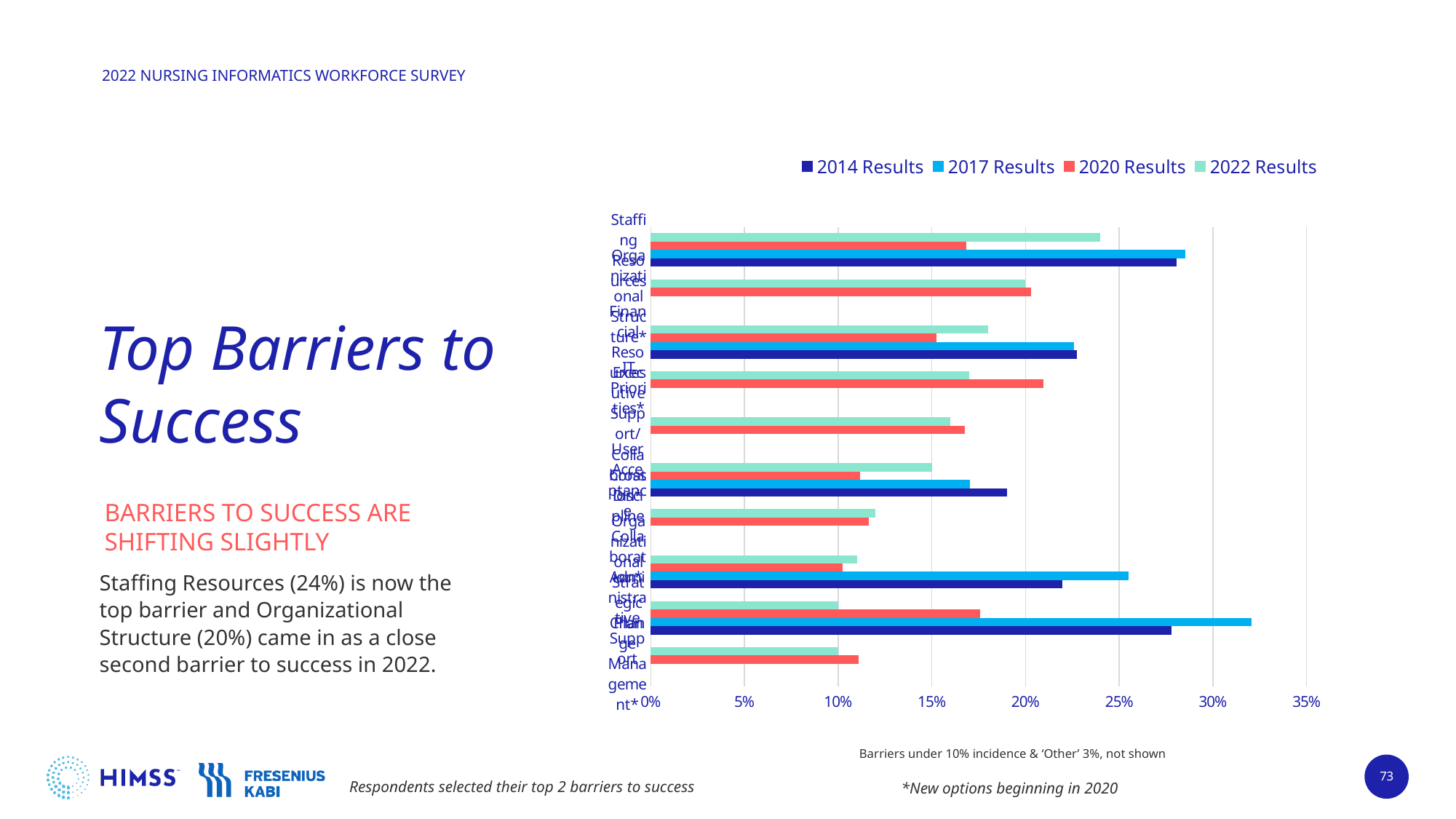
For Staffing Resources, which series has the highest value? 2017 Results Is the 2017 Results value for Staffing Resources greater or less than 25%? greater For Staffing Resources, which is larger: the 2017 Results value or the 2020 Results value? 2017 Results What is the 2022 Results value for Organizational Structure? 20% What kind of chart is shown on the slide? Bar chart How many series does the chart legend list? 4 Is the 2020 Results value for Staffing Resources greater or less than 20%? less Which series has the single longest bar on the chart? 2017 Results What are the four series listed in the chart legend? 2014 Results, 2017 Results, 2020 Results, 2022 Results What is the highest value shown on the chart's horizontal axis? 35% What is the 2022 Results value for Staffing Resources? 24% How many category groups of bars are plotted on the chart? 10